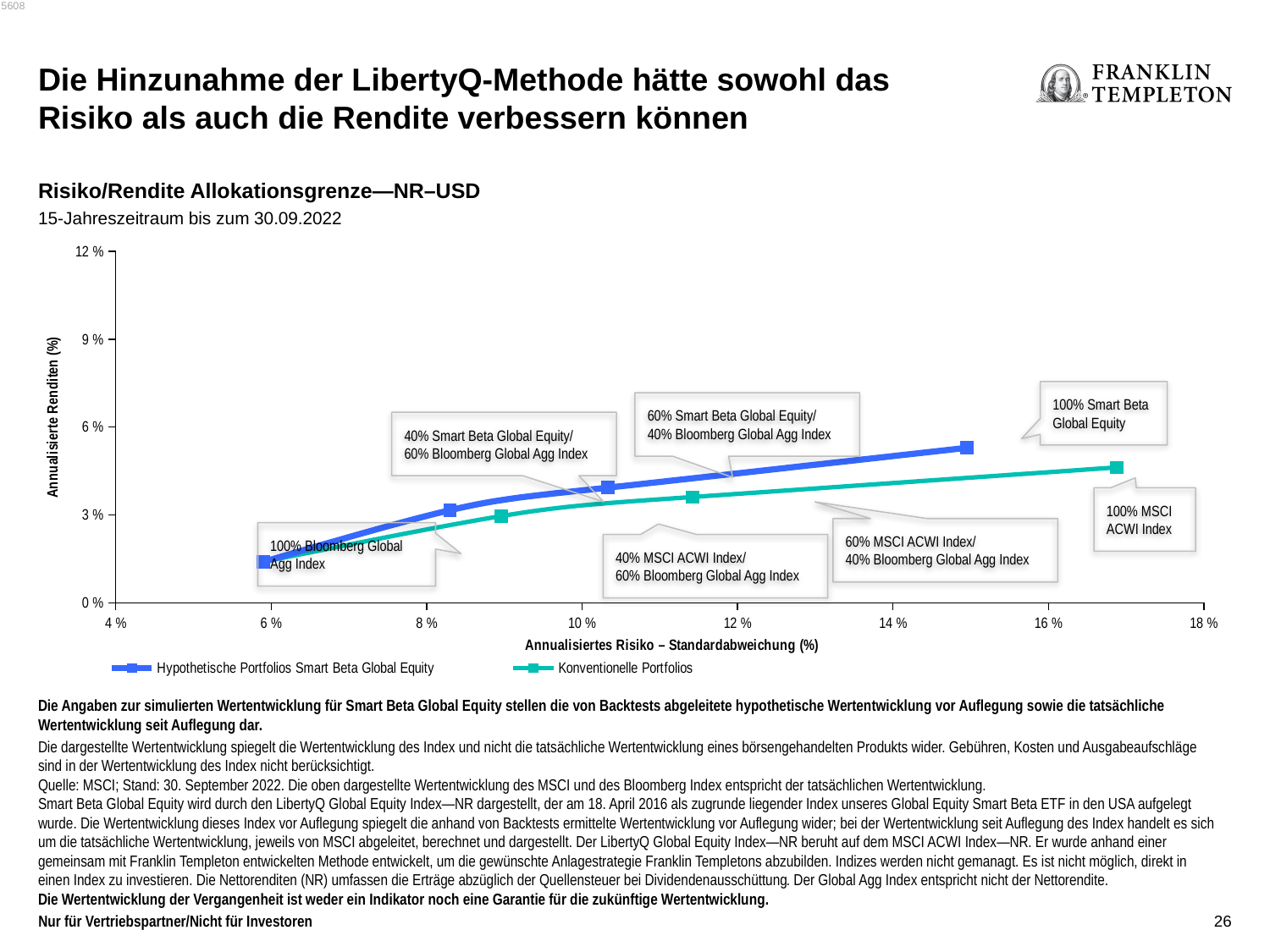
How many series does the legend list? 2 What are the two series named in the legend? Hypothetische Portfolios Smart Beta Global Equity; Konventionelle Portfolios What kind of chart is shown on the slide? Line chart Is the annualised return for the 100% Bloomberg Global Agg Index portfolio greater or less than 3 %? less Which has the higher annualised return: the 100% Smart Beta Global Equity portfolio or the 100% MSCI ACWI Index portfolio? 100% Smart Beta Global Equity Is the annualised return for the 100% Smart Beta Global Equity portfolio greater or less than 6 %? less Which has the higher annualised risk: the 100% Smart Beta Global Equity portfolio or the 100% MSCI ACWI Index portfolio? 100% MSCI ACWI Index How many labelled portfolio points are plotted on the Hypothetische Portfolios Smart Beta Global Equity line? 4 Do the annualised returns rise or fall as annualised risk increases along the x axis? rise Which plotted portfolio has the highest annualised return? 100% Smart Beta Global Equity What is the title of the chart? Risiko/Rendite Allokationsgrenze—NR–USD Is the annualised risk for the 100% MSCI ACWI Index portfolio greater or less than 16 %? greater